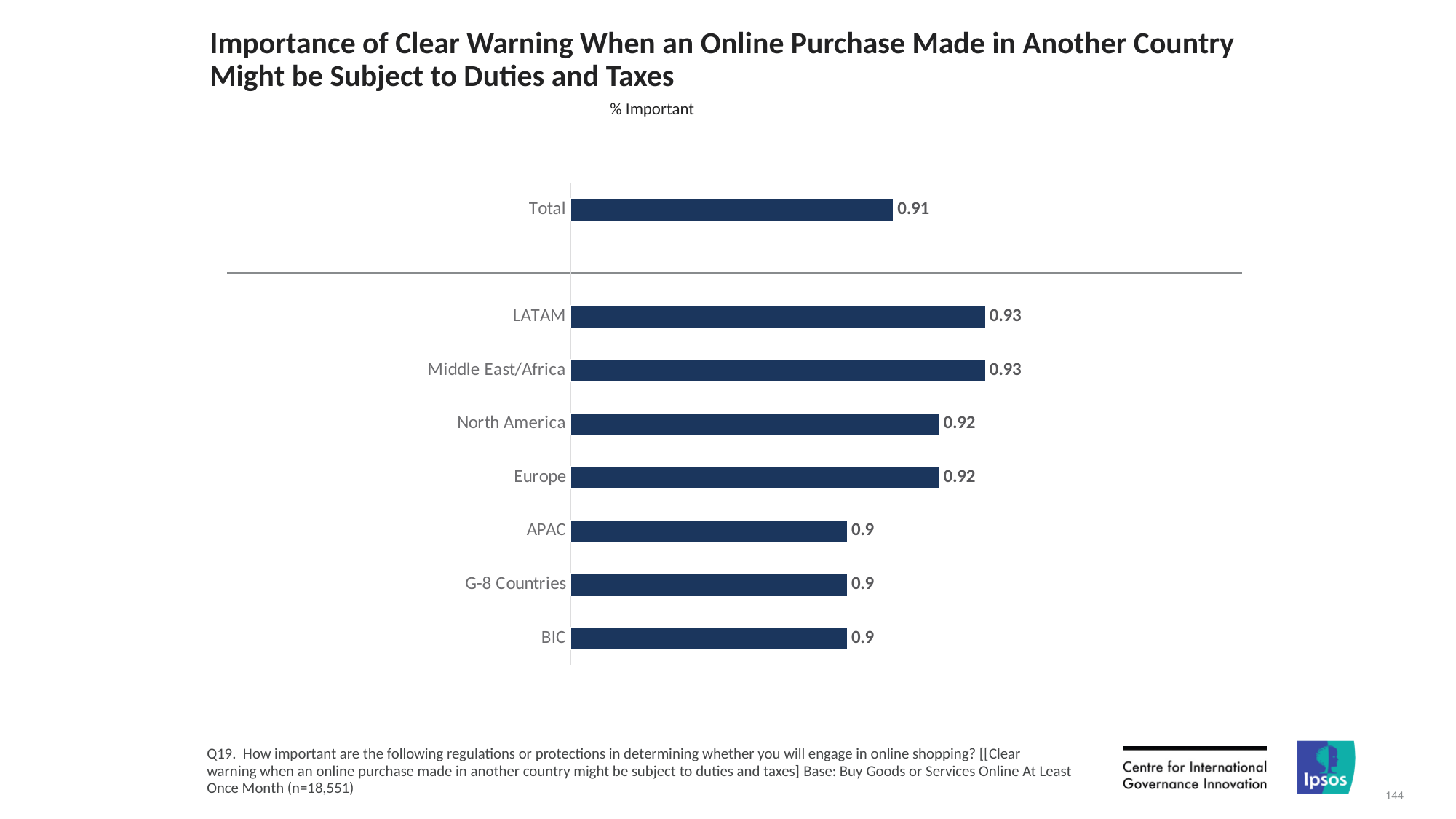
What is the value for North America? 0.92 What is the value for Middle East/Africa? 0.93 How many bars are plotted on the chart? 8 What is the value for Total? 0.91 What is the value for LATAM? 0.93 What is the value for BIC? 0.9 Which has a larger value, LATAM or APAC? LATAM What is the difference between the values for LATAM and BIC? 0.03 What is the value for G-8 Countries? 0.9 What kind of chart is shown on the slide? Bar chart What is the value for Europe? 0.92 What is the value for APAC? 0.9